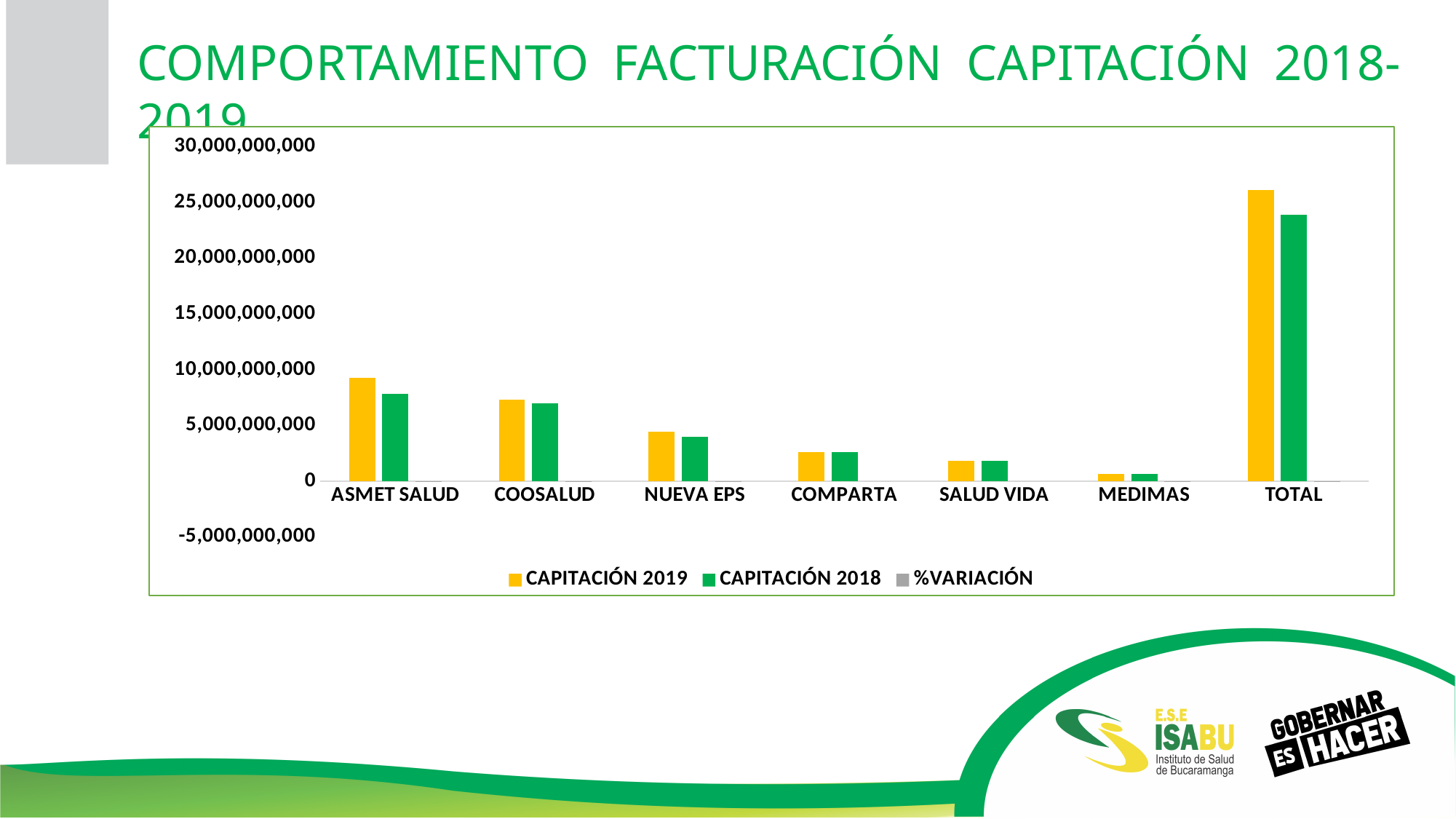
What kind of chart is shown on the slide? Bar chart Which category has the highest CAPITACIÓN 2019 value? TOTAL Which category has the lowest CAPITACIÓN 2019 value? MEDIMAS Is the CAPITACIÓN 2018 value for COOSALUD greater or less than 5,000,000,000? greater Which colour represents the CAPITACIÓN 2018 series in the legend? Green For TOTAL, which is larger: CAPITACIÓN 2019 or CAPITACIÓN 2018? CAPITACIÓN 2019 How many series does the chart legend list? 3 For ASMET SALUD, which is larger: CAPITACIÓN 2019 or CAPITACIÓN 2018? CAPITACIÓN 2019 Excluding TOTAL, which category has the highest CAPITACIÓN 2018 value? ASMET SALUD Is the CAPITACIÓN 2019 value for TOTAL greater or less than 25,000,000,000? greater How many categories are shown along the x axis of the chart? 7 Is the CAPITACIÓN 2019 value for ASMET SALUD greater or less than 10,000,000,000? less